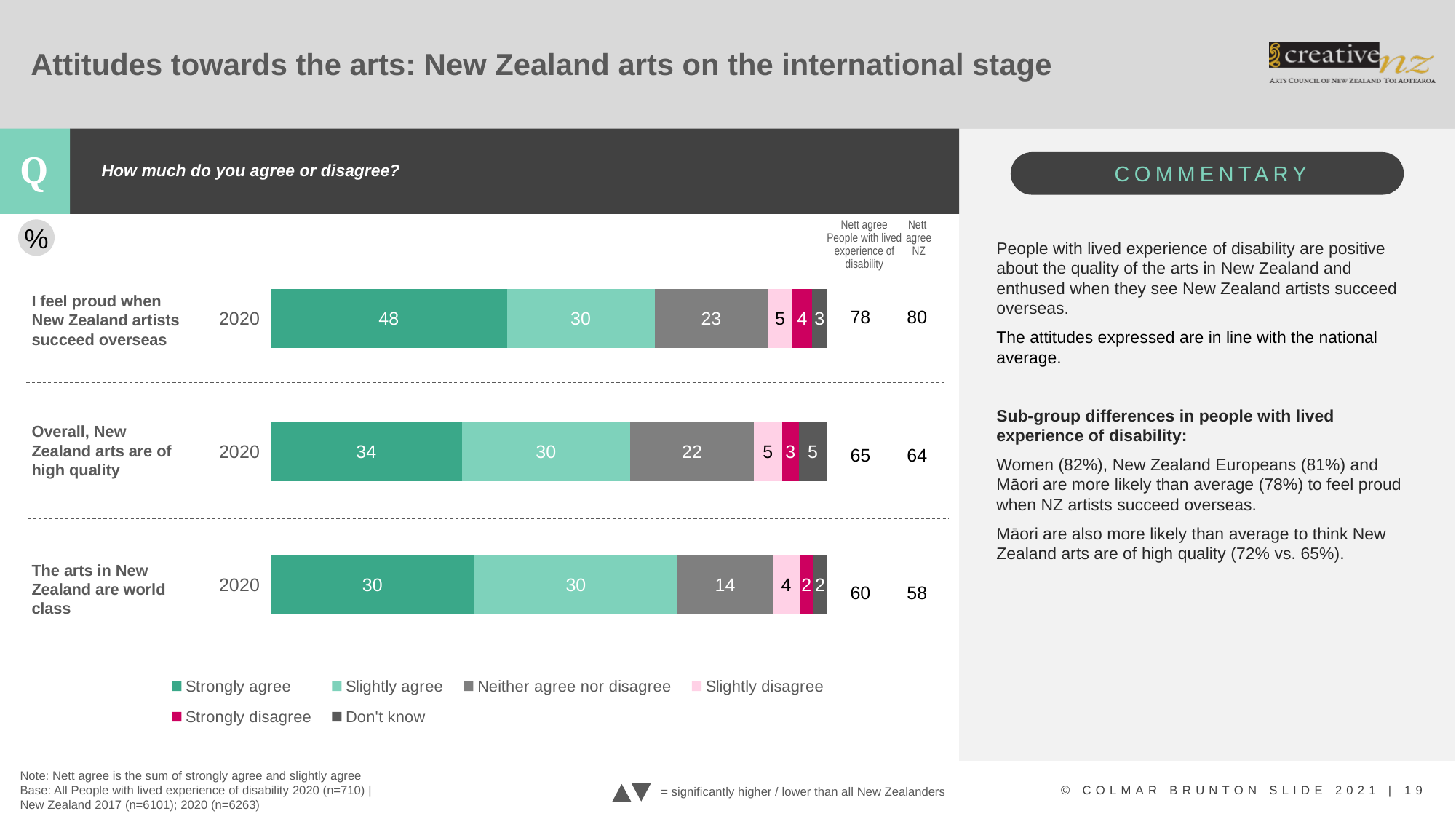
What percentage of people with lived experience of disability strongly agree that they feel proud when New Zealand artists succeed overseas? 48 What is the 'Slightly disagree' value for the statement 'The arts in New Zealand are world class'? 4 Which statement has the lowest 'Neither agree nor disagree' value? The arts in New Zealand are world class Which statement has the larger 'Don't know' value: 'Overall, New Zealand arts are of high quality' or 'I feel proud when New Zealand artists succeed overseas'? Overall, New Zealand arts are of high quality What is the difference in 'Strongly agree' between 'I feel proud when New Zealand artists succeed overseas' and 'Overall, New Zealand arts are of high quality'? 14 Which statement has the highest 'Strongly agree' value? I feel proud when New Zealand artists succeed overseas What is the 'Neither agree nor disagree' value for the statement 'Overall, New Zealand arts are of high quality'? 22 What kind of chart is shown on the slide? Stacked bar chart How many response categories does the legend list? 6 What is the Nett agree NZ figure shown for 'I feel proud when New Zealand artists succeed overseas'? 80 How many statements are plotted in the chart? 3 What is the Nett agree (people with lived experience of disability) for 'The arts in New Zealand are world class'? 60